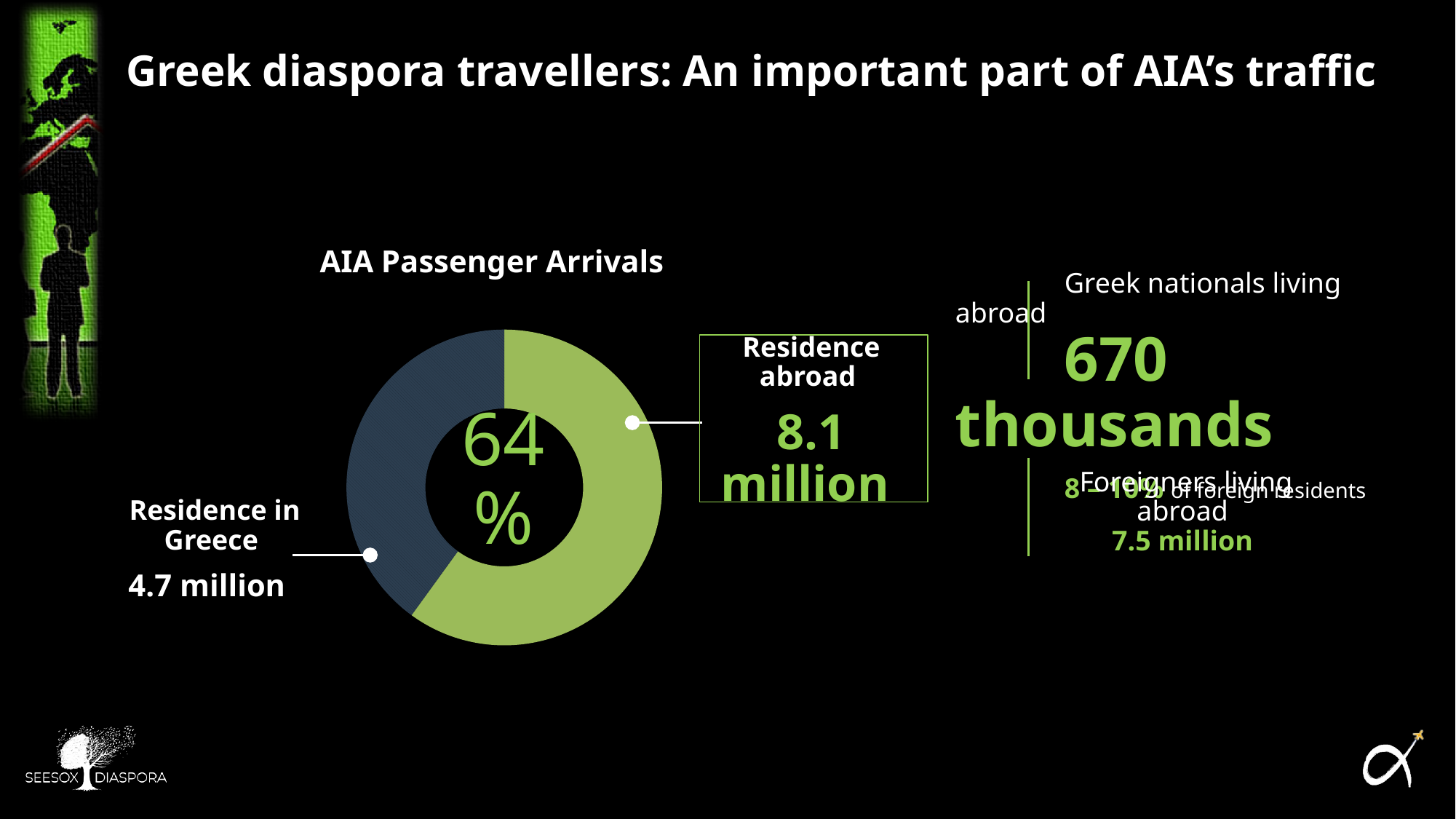
What percentage share is shown in the centre of the AIA Passenger Arrivals chart for Residence abroad? 64% What is the total of the two categories in the AIA Passenger Arrivals chart? 12.8 million What colour is the Residence abroad slice in the AIA Passenger Arrivals chart? Green In the AIA Passenger Arrivals chart, what is the value for Residence abroad? 8.1 million How many categories does the AIA Passenger Arrivals chart show? 2 Which category in the AIA Passenger Arrivals chart has the largest value? Residence abroad In the AIA Passenger Arrivals chart, which is larger: Residence abroad or Residence in Greece? Residence abroad Which category in the AIA Passenger Arrivals chart has the smallest value? Residence in Greece What is the title of the chart on the slide? AIA Passenger Arrivals What kind of chart is the AIA Passenger Arrivals chart? Pie chart (donut) What is the difference between Residence abroad and Residence in Greece in the AIA Passenger Arrivals chart? 3.4 million In the AIA Passenger Arrivals chart, what is the value for Residence in Greece? 4.7 million